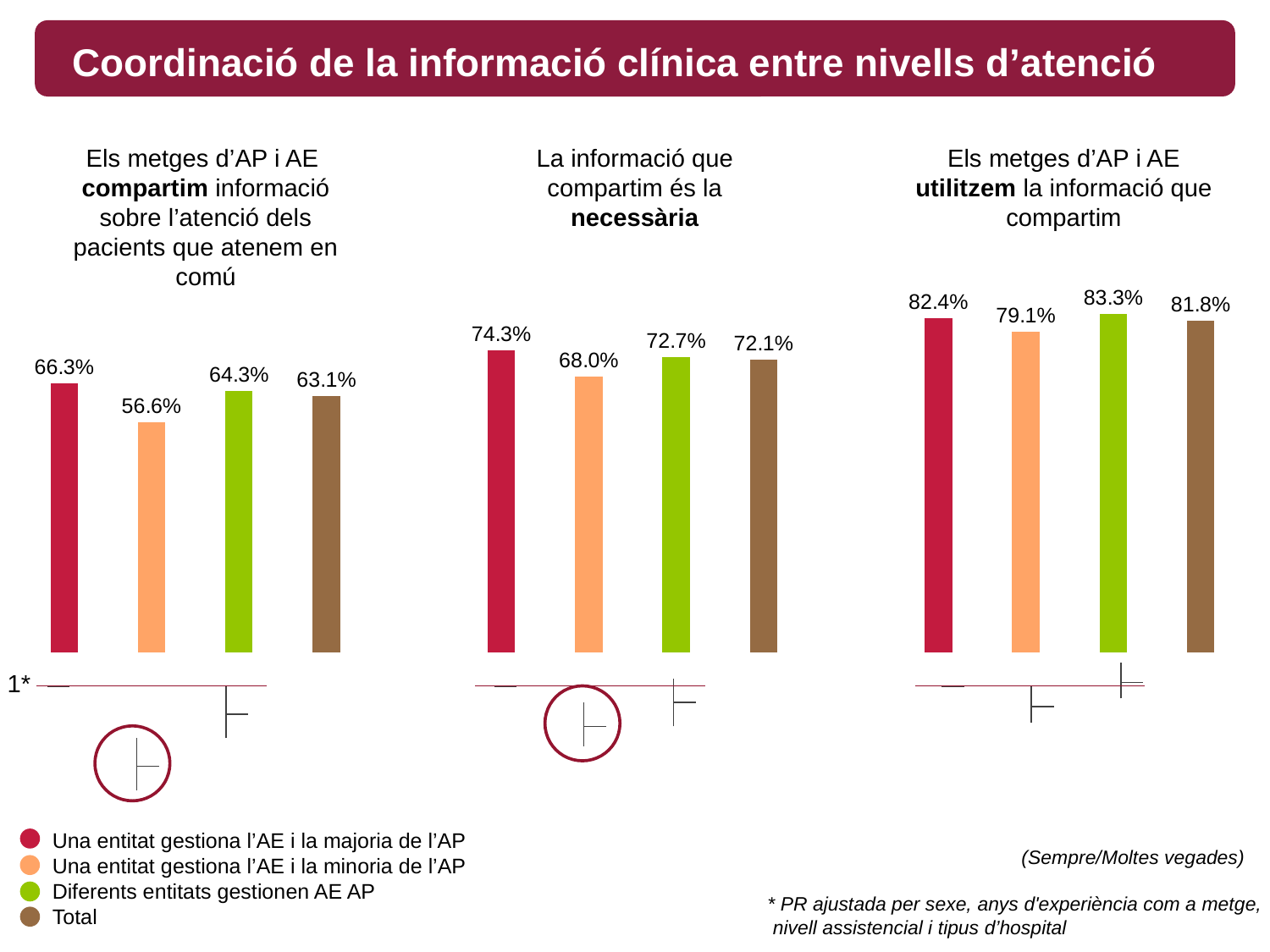
How many bars does the left chart ("Els metges d'AP i AE compartim informació...") have? 4 In the left chart ("Els metges d'AP i AE compartim informació..."), which category has the lowest value? Una entitat gestiona l'AE i la minoria de l'AP How many entries does the legend at the bottom of the slide list? 4 In the right chart ("Els metges d'AP i AE utilitzem la informació que compartim"), which category has the lowest value? Una entitat gestiona l'AE i la minoria de l'AP In the middle chart ("La informació que compartim és la necessària"), what is the difference between "Una entitat gestiona l'AE i la majoria de l'AP" and "Total"? 2.2% In the right chart ("Els metges d'AP i AE utilitzem la informació que compartim"), what is the value for "Diferents entitats gestionen AE AP"? 83.3% What kind of chart is the middle chart ("La informació que compartim és la necessària")? Bar chart In the middle chart ("La informació que compartim és la necessària"), which category has the highest value? Una entitat gestiona l'AE i la majoria de l'AP In the left chart ("Els metges d'AP i AE compartim informació..."), what is the value for "Total"? 63.1% In the left chart ("Els metges d'AP i AE compartim informació..."), what is the difference between "Una entitat gestiona l'AE i la majoria de l'AP" and "Una entitat gestiona l'AE i la minoria de l'AP"? 9.7% In the middle chart ("La informació que compartim és la necessària"), what is the value for "Una entitat gestiona l'AE i la minoria de l'AP"? 68.0% In the right chart ("Els metges d'AP i AE utilitzem la informació que compartim"), which is larger: "Una entitat gestiona l'AE i la majoria de l'AP" or "Total"? Una entitat gestiona l'AE i la majoria de l'AP